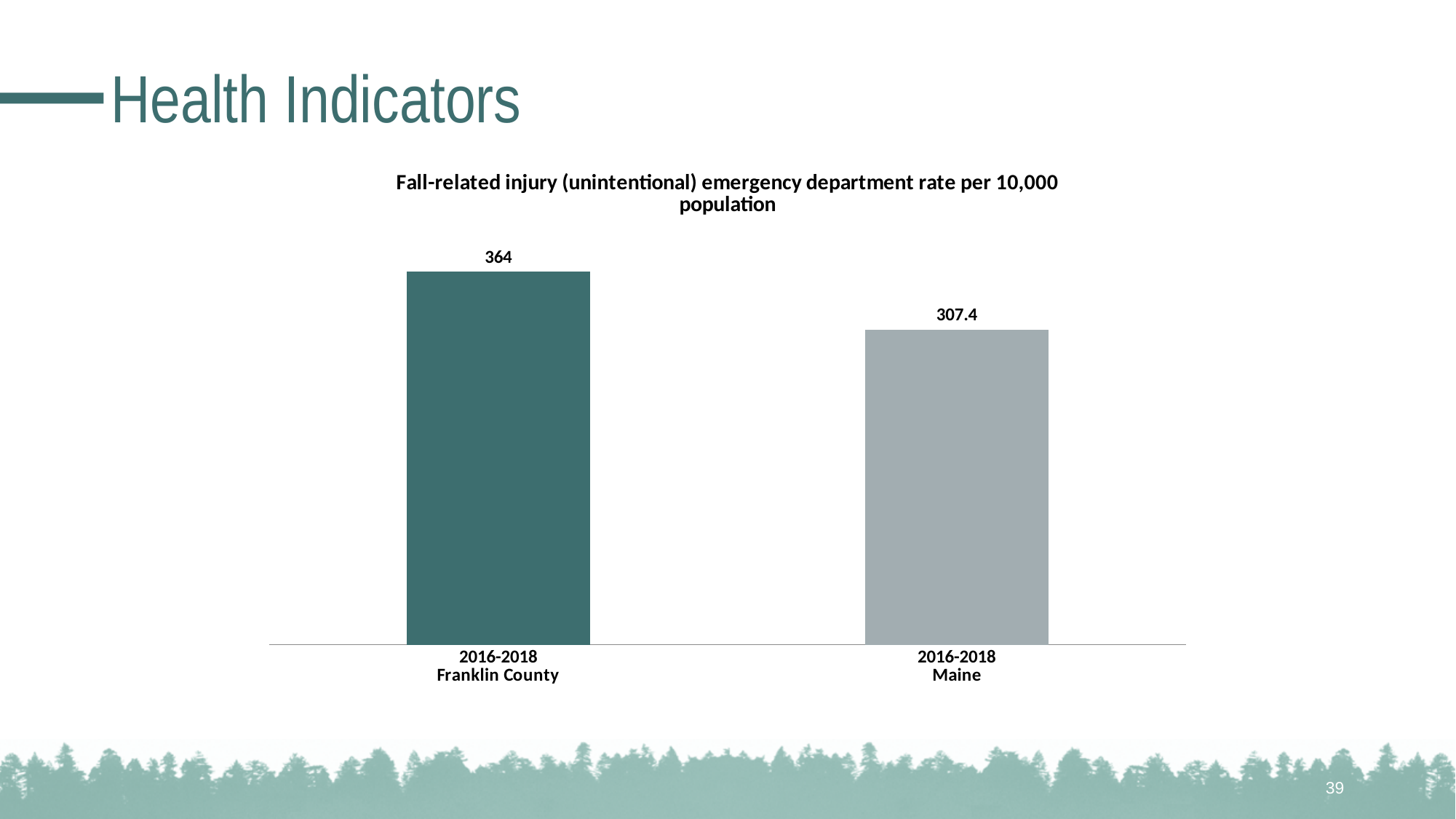
Which category has the higher fall-related injury emergency department rate? 2016-2018 Franklin County What is the fall-related injury emergency department rate per 10,000 population for Maine (2016-2018)? 307.4 What time period do both bars in the chart cover? 2016-2018 Is the rate for Franklin County larger or smaller than the rate for Maine? larger How many bars are shown in the chart? 2 What is the fall-related injury emergency department rate per 10,000 population for Franklin County (2016-2018)? 364 What is the title of the chart? Fall-related injury (unintentional) emergency department rate per 10,000 population What is the difference between the Franklin County rate and the Maine rate? 56.6 What type of chart is shown on the slide? bar chart Which category has the lower fall-related injury emergency department rate? 2016-2018 Maine